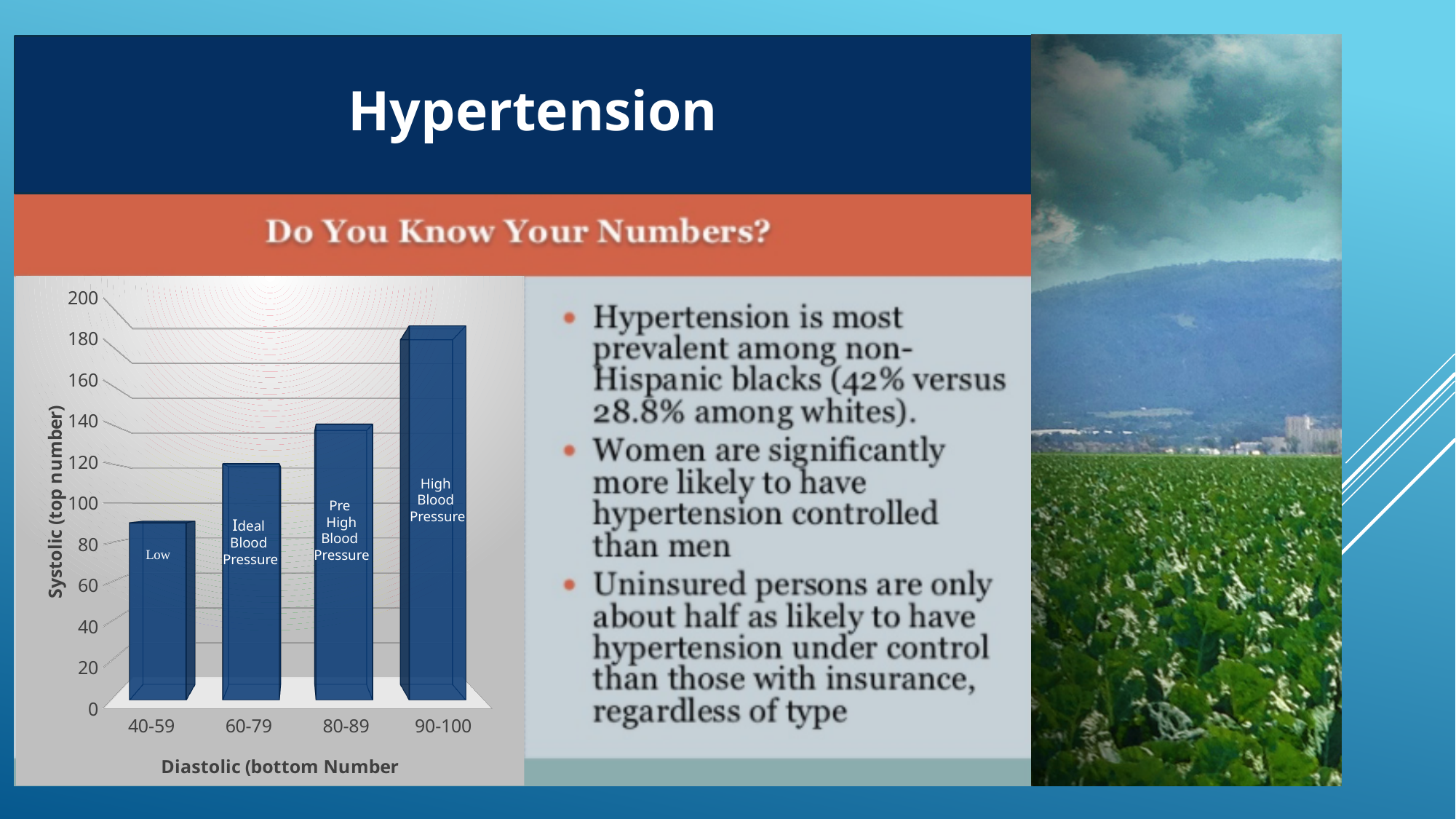
What kind of chart is shown on the slide? bar chart Which diastolic category has the highest systolic bar? 90-100 What label is written on the bar for the 80-89 category? Pre High Blood Pressure Is the value for the 80-89 category greater or less than 160? less How many bars (diastolic categories) does the chart show? 4 Is the value for the 60-79 category greater or less than 100? greater Which is larger, the bar for 60-79 or the bar for 80-89? 80-89 Is the value for the 90-100 category greater or less than 160? greater Which diastolic category has the lowest systolic bar? 40-59 What is the title of the vertical axis of the chart? Systolic (top number) Do the bar values rise or fall as the diastolic categories increase along the x axis? rise